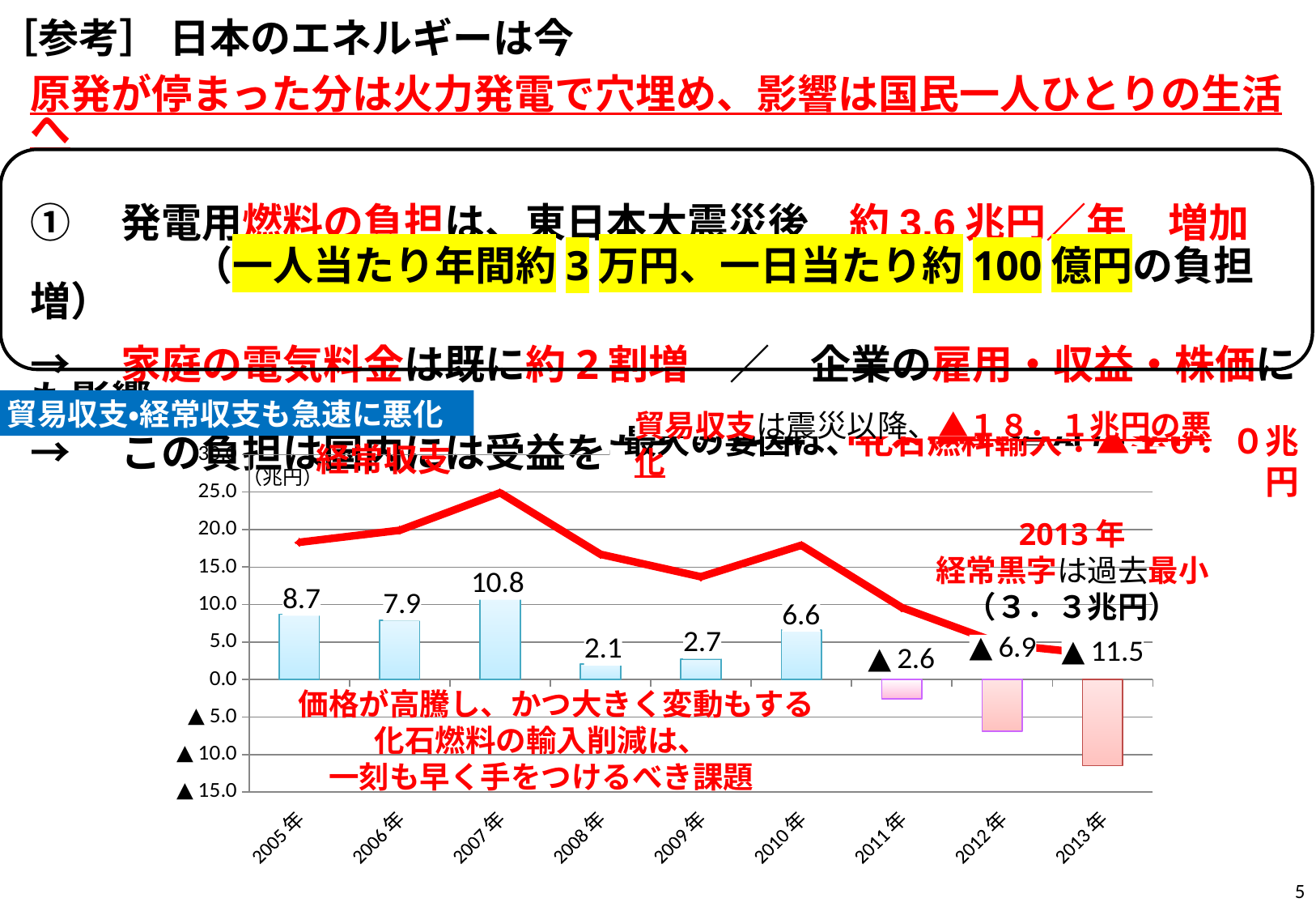
What is the difference between the bar values for 2005年 and 2006年? 0.8 Does the red line rise or fall from 2010年 to 2013年? fall Which year has the larger bar value, 2008年 or 2009年? 2009年 What unit is shown on the vertical axis of the chart? 兆円 What is the value of the bar for 2007年? 10.8 What is the value of the bar for 2011年? ▲2.6 How many years are shown on the x axis of the chart? 9 Which year has the lowest bar value? 2013年 Which year has the highest bar value? 2007年 Is the value of the red line for 2007年 greater or less than 20.0? greater Is the value of the red line for 2013年 greater or less than 5.0? less What is the value of the bar for 2013年? ▲11.5